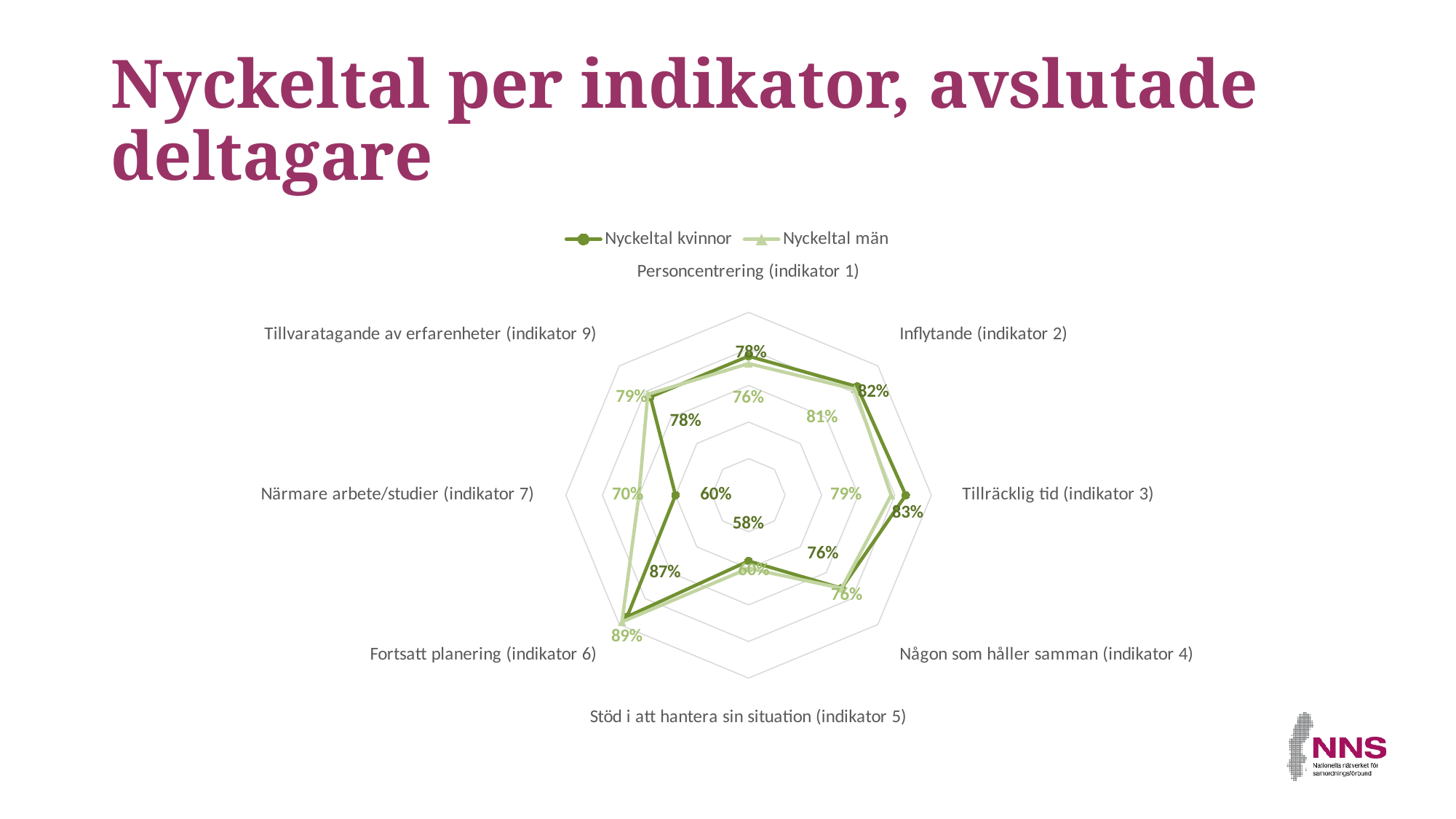
How many indicator categories are plotted on the chart? 8 What is the value of Nyckeltal kvinnor for Tillräcklig tid (indikator 3)? 83% What kind of chart is shown on the slide? Radar chart Which indicator has the highest value for Nyckeltal män? Fortsatt planering (indikator 6) What are the two series names shown in the legend? Nyckeltal kvinnor and Nyckeltal män What is the value of Nyckeltal män for Stöd i att hantera sin situation (indikator 5)? 60% Which indicator has the lowest value for Nyckeltal män? Stöd i att hantera sin situation (indikator 5) For Tillräcklig tid (indikator 3), which series has the larger value, Nyckeltal kvinnor or Nyckeltal män? Nyckeltal kvinnor How many series does the legend list? 2 What is the difference between Nyckeltal män and Nyckeltal kvinnor for Närmare arbete/studier (indikator 7)? 10 percentage points What is the value of Nyckeltal män for Närmare arbete/studier (indikator 7)? 70% What is the value of Nyckeltal kvinnor for Fortsatt planering (indikator 6)? 87%